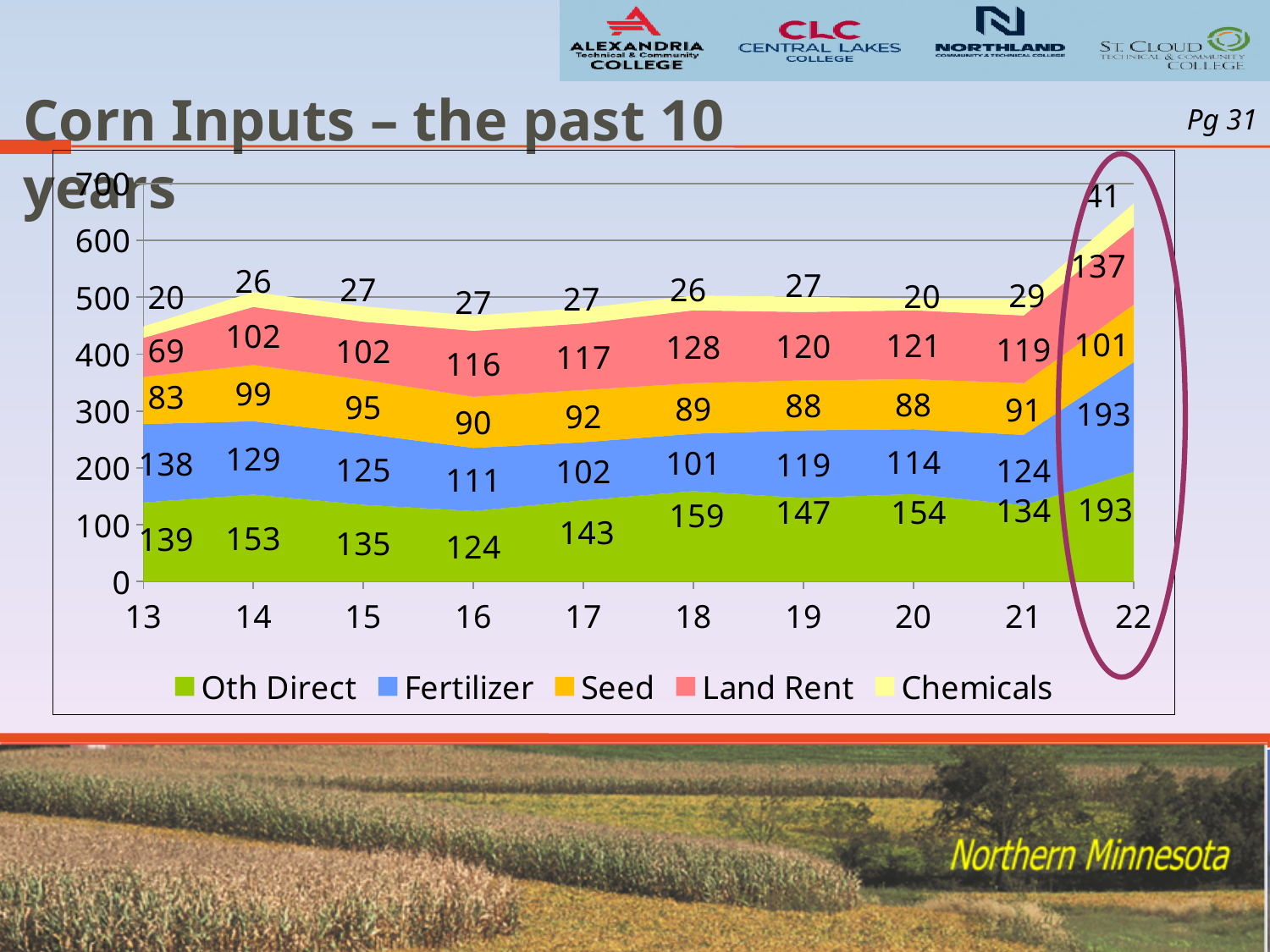
How many series does the legend list? 5 What is the difference between the Fertilizer value in year 22 and in year 21? 69 In which year is the Oth Direct value highest? 22 What is the Seed value for year 13? 83 How many years are shown on the x axis? 10 Which is larger, the Seed value in year 14 or the Seed value in year 16? Seed in year 14 What is the Land Rent value for year 18? 128 What kind of chart is shown on the slide? Stacked area chart What is the total of all five inputs for year 22? 665 What is the Fertilizer value for year 22? 193 In which year is the Land Rent value lowest? 13 What is the Chemicals value for year 21? 29